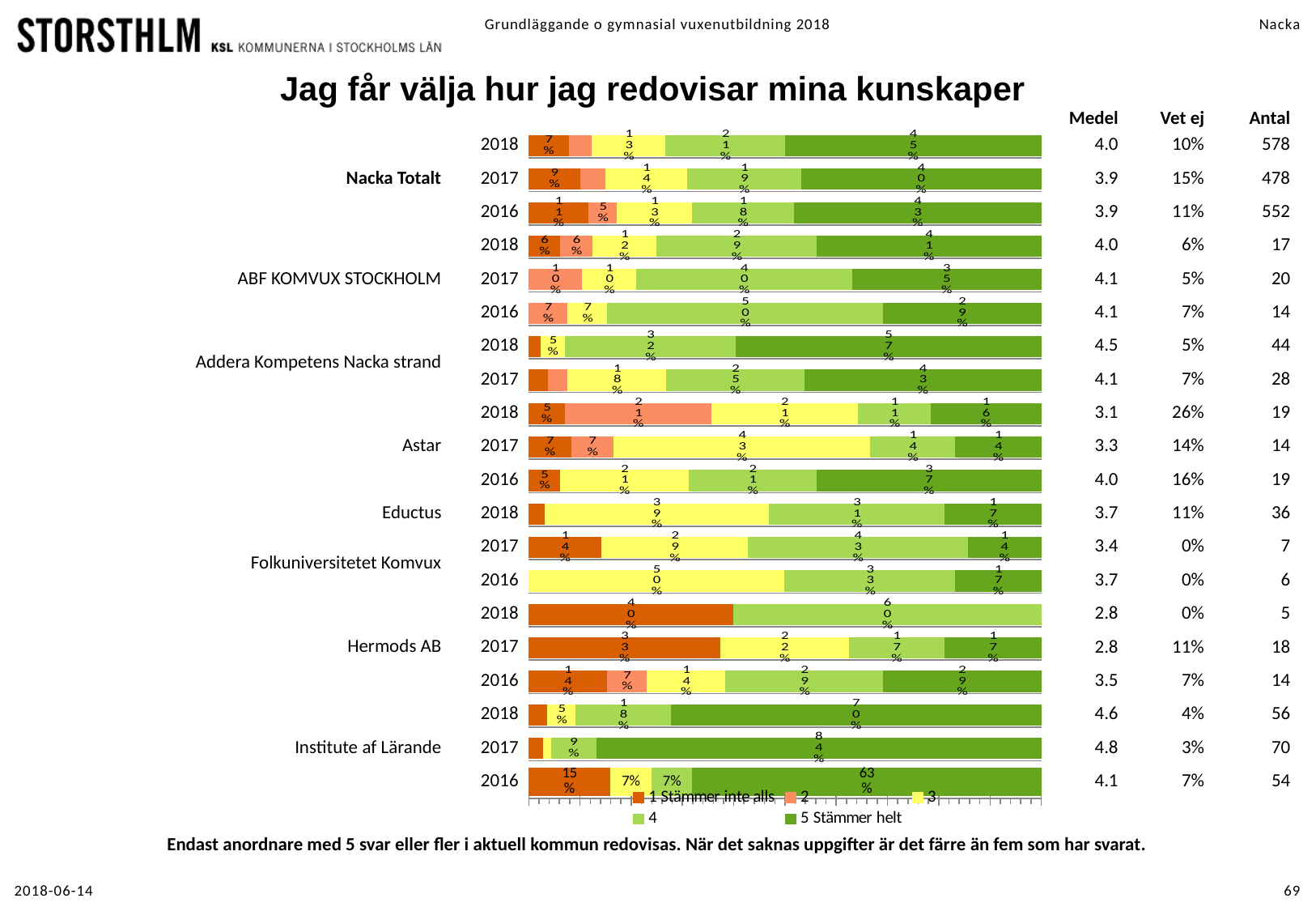
How many series does the chart legend list? 5 What is the title of the chart? Jag får välja hur jag redovisar mina kunskaper What percentage of Addera Kompetens Nacka strand 2018 responses are '5 Stämmer helt'? 57% What percentage of Hermods AB 2018 responses are '1 Stämmer inte alls'? 40% How many bars are plotted in the chart? 20 Which row has the highest Antal value? Nacka Totalt 2018 What kind of chart is shown on the slide? Stacked bar chart Which row has the highest Medel value? Institute af Lärande 2017 What is the Antal value for Institute af Lärande 2017? 70 What is the Medel value for Nacka Totalt 2018? 4.0 What is the difference in the '5 Stämmer helt' share between Institute af Lärande 2017 and 2018? 14 percentage points What percentage of Institute af Lärande 2017 responses are '5 Stämmer helt'? 84%